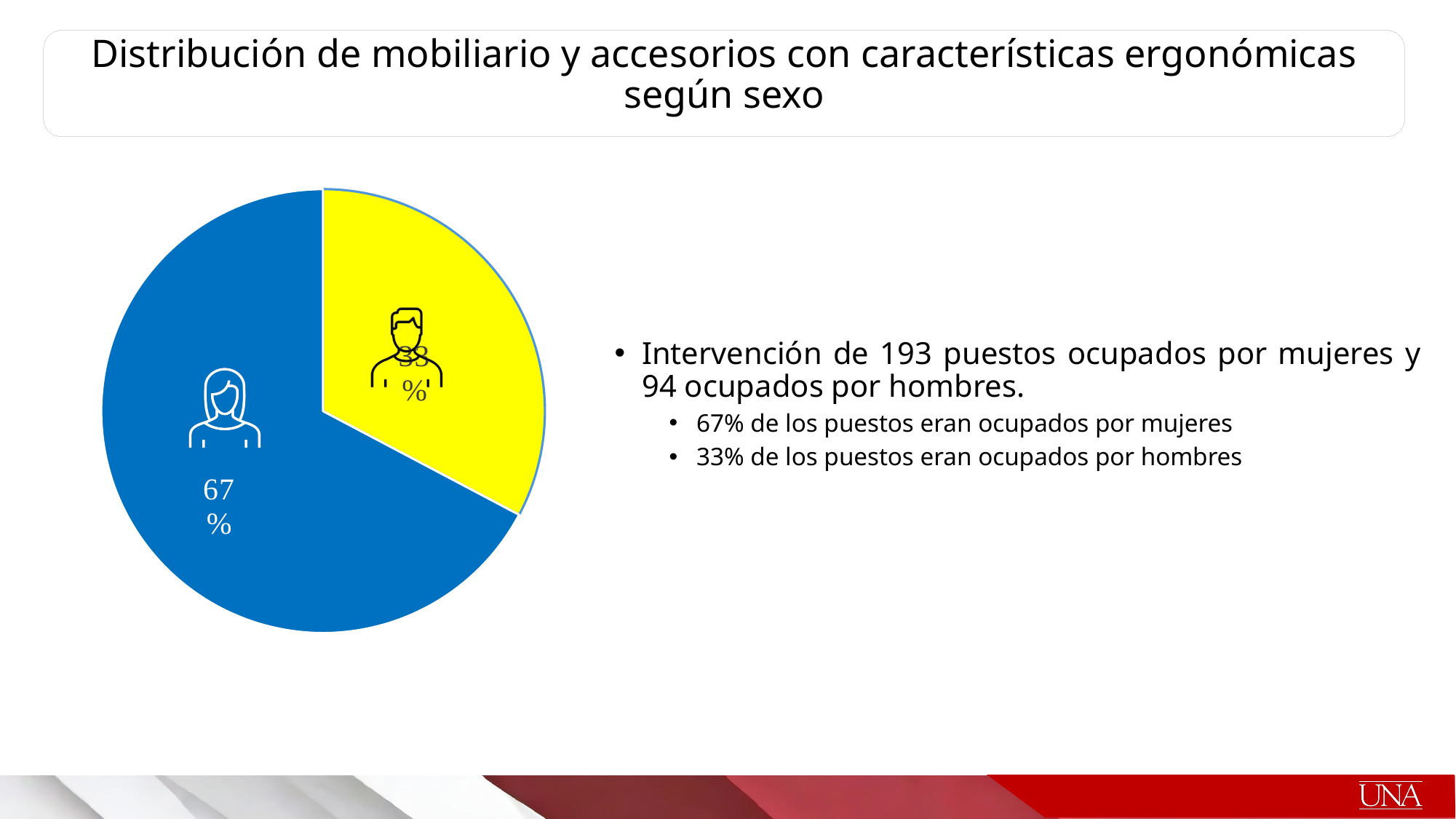
What percentage is shown on the blue slice of the pie chart? 67% How many slices does the pie chart have? 2 What percentage is shown on the yellow slice of the pie chart? 33% Is the share of the blue slice in the pie chart greater or less than 50%? greater Is the blue slice or the yellow slice of the pie chart larger? the blue slice Which slice of the pie chart carries the icon of a woman? the blue slice Which slice of the pie chart is the largest? the blue slice (67%) What is the title of the slide containing the pie chart? Distribución de mobiliario y accesorios con características ergonómicas según sexo What kind of chart is shown on the slide? pie chart Which slice of the pie chart is the smallest? the yellow slice (33%) By how many percentage points does the blue slice exceed the yellow slice in the pie chart? 34